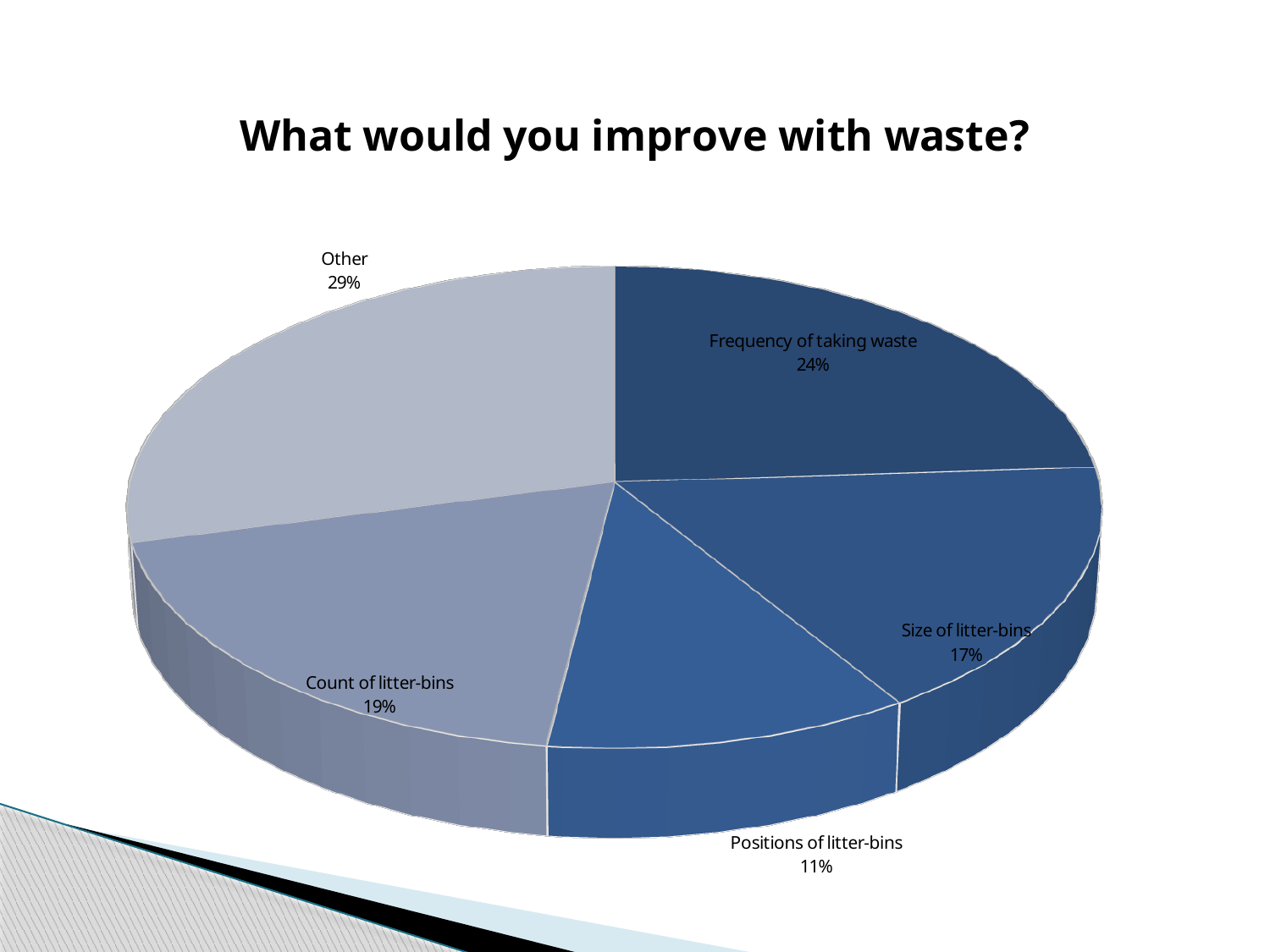
What share of the pie is 'Frequency of taking waste'? 24% Which category has the smallest slice of the pie? Positions of litter-bins What is the difference in percentage points between 'Size of litter-bins' and 'Positions of litter-bins'? 6 What is the difference in percentage points between 'Other' and 'Frequency of taking waste'? 5 What percentage is shown for 'Count of litter-bins'? 19% What kind of chart is shown on the slide? Pie chart Which is larger, 'Count of litter-bins' or 'Size of litter-bins'? Count of litter-bins How many slices does the pie chart have? 5 Which category has the largest slice of the pie? Other What is the title of the chart? What would you improve with waste? What percentage is shown for 'Size of litter-bins'? 17% What percentage is shown for 'Positions of litter-bins'? 11%